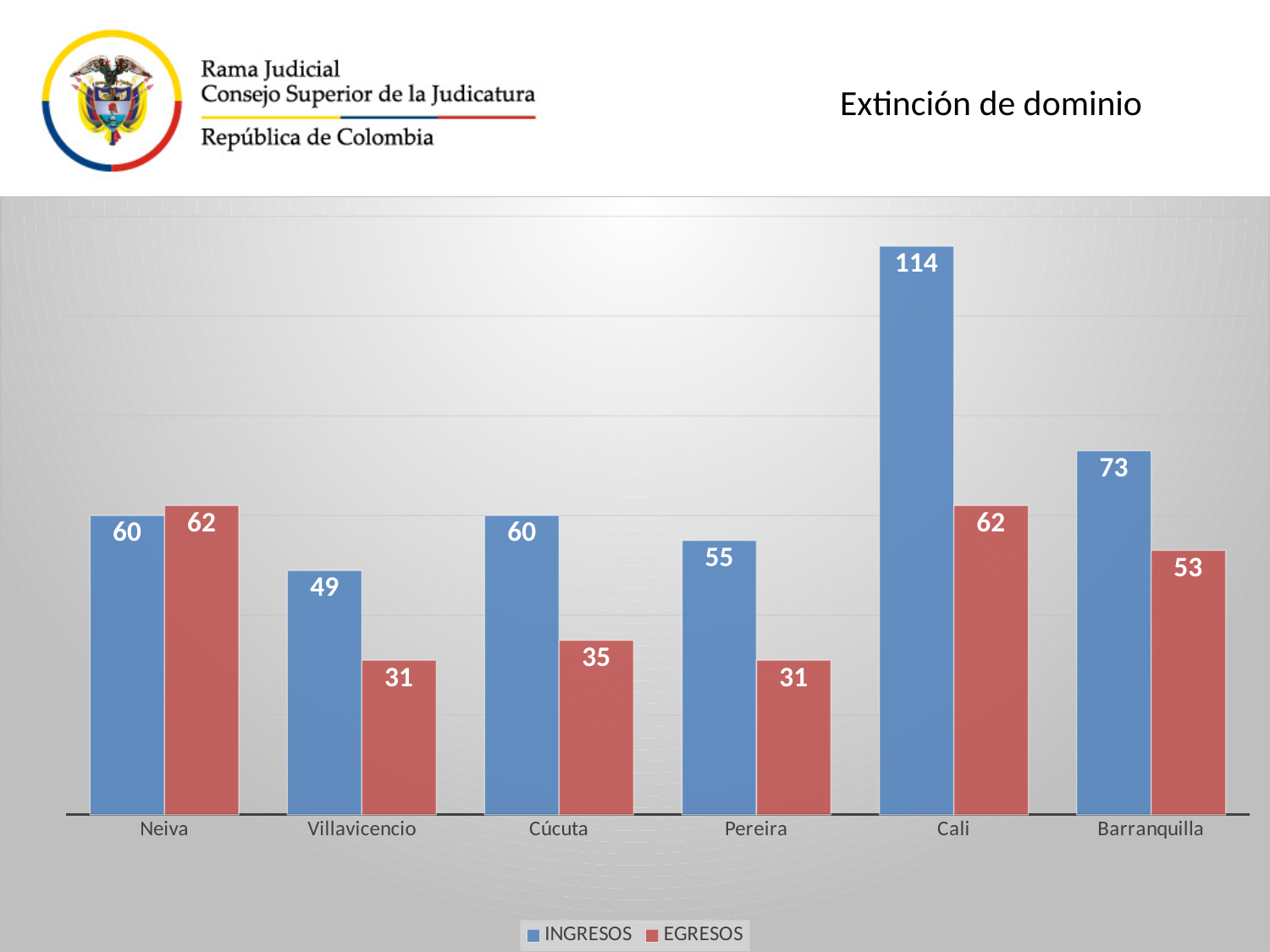
How many cities are shown on the x axis? 6 Which city has the highest INGRESOS value? Cali Which is larger for Neiva, INGRESOS or EGRESOS? EGRESOS What kind of chart is shown on the slide? Bar chart What is the EGRESOS value for Cúcuta? 35 What is the difference between INGRESOS and EGRESOS for Cali? 52 What is the difference between the INGRESOS values for Barranquilla and Pereira? 18 What is the EGRESOS value for Villavicencio? 31 How many series does the legend list? 2 What is the INGRESOS value for Cali? 114 What is the INGRESOS value for Barranquilla? 73 Which city has the lowest INGRESOS value? Villavicencio